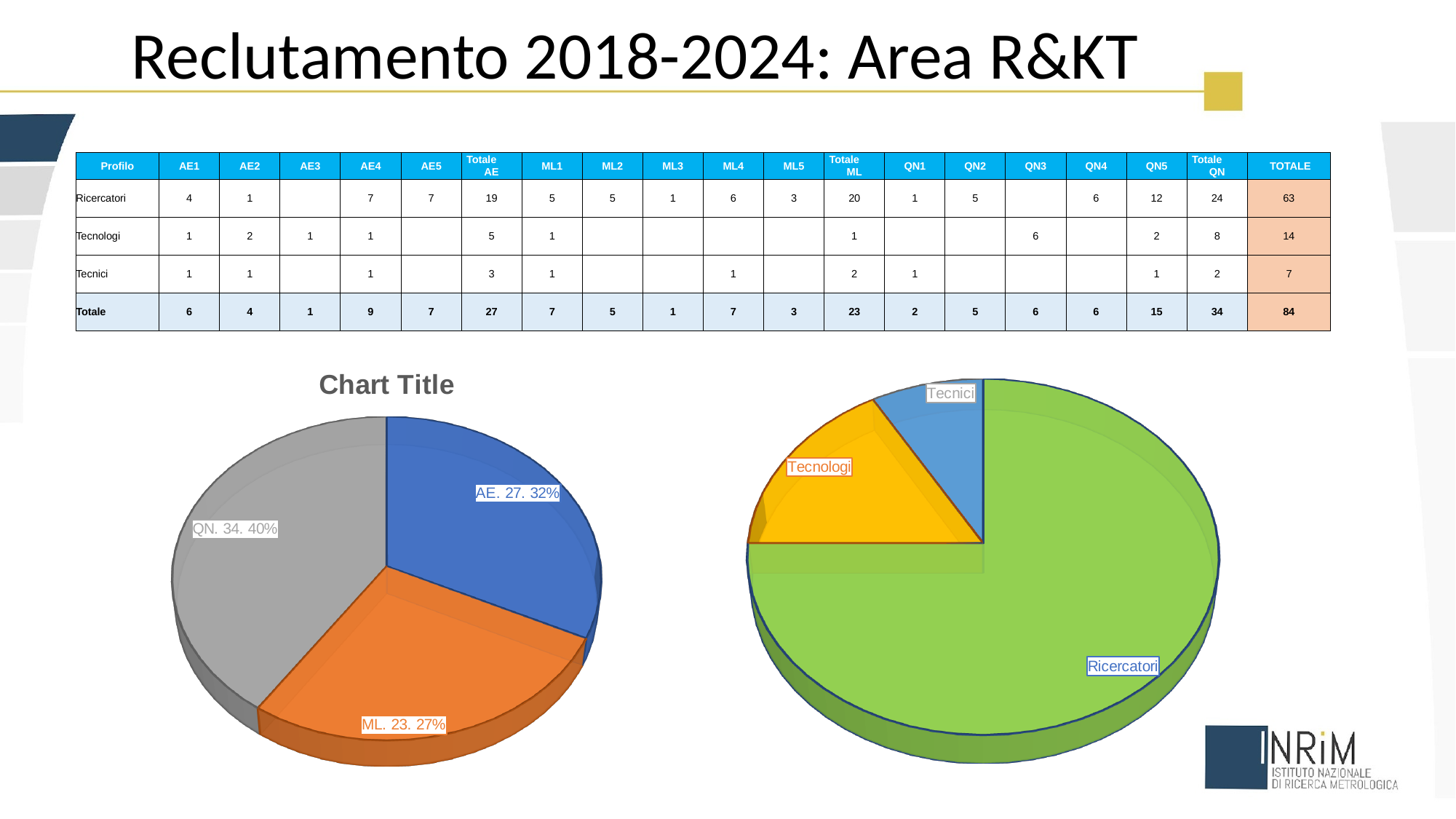
In the left pie chart titled "Chart Title", what share of the pie does QN represent? 40% In the left pie chart titled "Chart Title", what is the value for QN? 34 In the left pie chart titled "Chart Title", what is the value for AE? 27 In the pie chart on the right of the slide, which category has the largest slice? Ricercatori In the left pie chart titled "Chart Title", how many slices does the pie have? 3 In the pie chart on the right of the slide, which category has the smallest slice? Tecnici In the left pie chart titled "Chart Title", what is the value for ML? 23 In the left pie chart titled "Chart Title", which category has the largest slice? QN What kind of chart is the chart on the right of the slide? Pie chart In the left pie chart titled "Chart Title", which category has the smallest slice? ML In the left pie chart titled "Chart Title", what is the difference between the values for QN and ML? 11 In the left pie chart titled "Chart Title", what share of the pie does ML represent? 27%